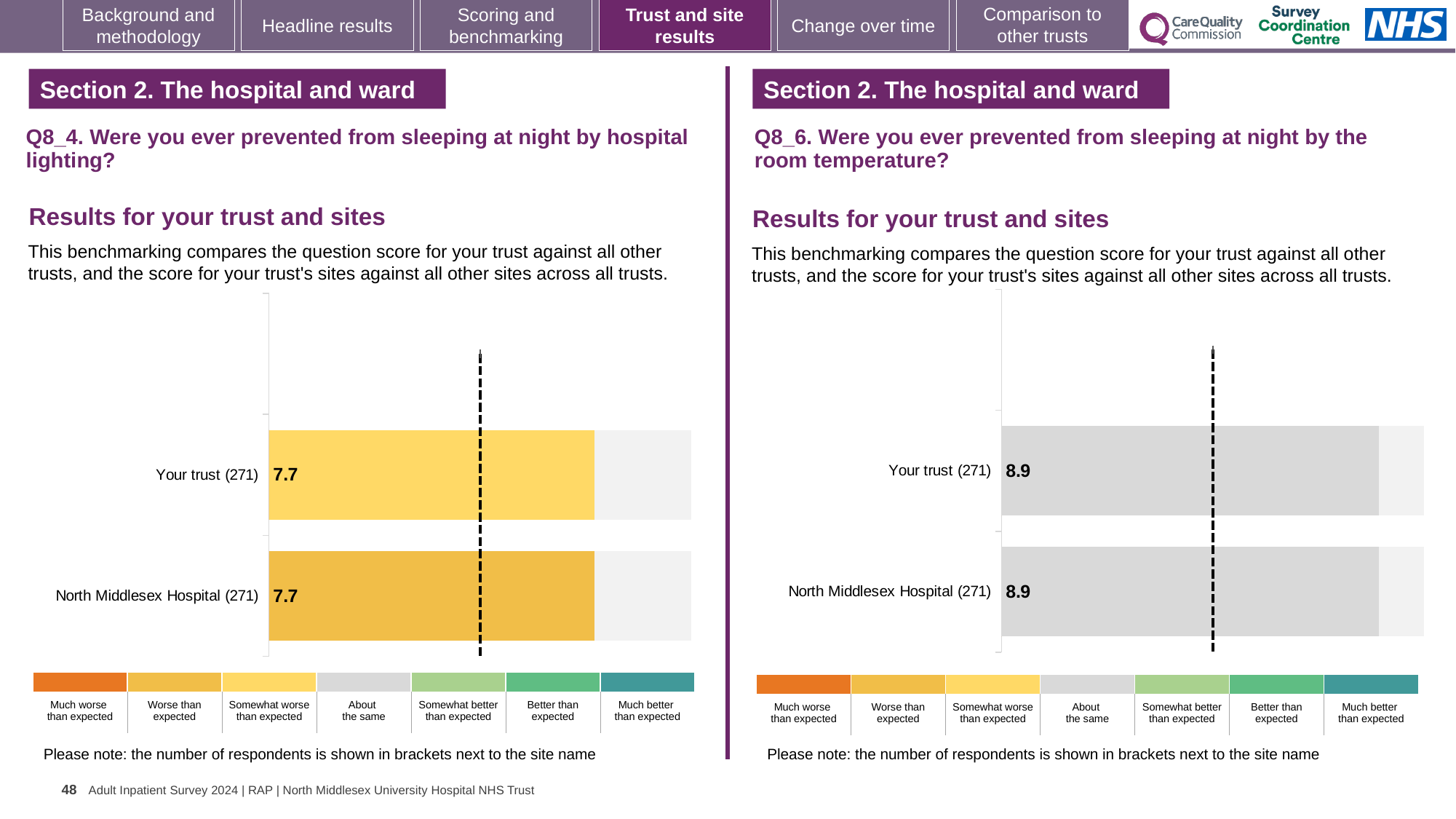
In the Q8_4 chart on the left, what is the score for Your trust (271)? 7.7 How many bars are plotted in the Q8_4 chart on the left? 2 In the Q8_6 chart on the right, which benchmark category does the grey colour of the bars correspond to in the legend? About the same How many respondents are shown in brackets for North Middlesex Hospital in the Q8_4 chart on the left? 271 In the Q8_6 chart on the right, what is the score for Your trust (271)? 8.9 In the Q8_4 chart on the left, what is the score for North Middlesex Hospital (271)? 7.7 In the Q8_6 chart on the right, what is the score for North Middlesex Hospital (271)? 8.9 In the Q8_4 chart on the left, what is the difference between the score for Your trust and the score for North Middlesex Hospital? 0 In the Q8_6 chart on the right, what is the difference between the score for Your trust and the score for North Middlesex Hospital? 0 How many benchmark categories are shown in the colour legend below the Q8_4 chart on the left? 7 How many bars are plotted in the Q8_6 chart on the right? 2 What kind of chart is used for the Q8_6 results on the right? Bar chart